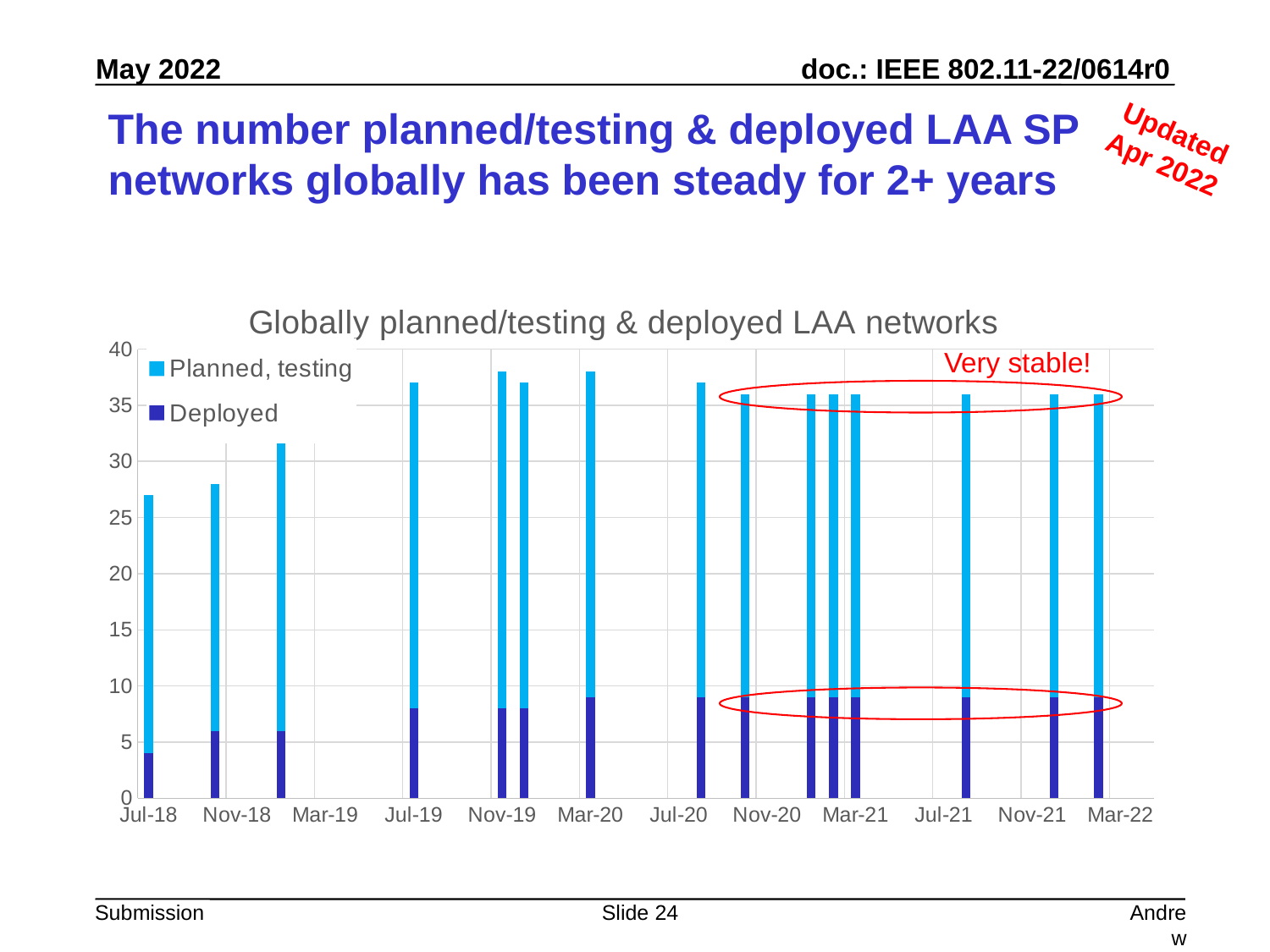
Which has a larger total bar, Jul-18 or Jul-19? Jul-19 Which series is shown in dark blue at the bottom of each bar? Deployed Is the total bar height for Jul-19 greater or less than 35? greater Is the Deployed value for Jul-19 greater or less than 10? less What kind of chart is shown on the slide? Stacked bar chart How many series does the chart legend list? 2 Is the Deployed value for Jul-18 greater or less than 10? less What is the title of the chart? Globally planned/testing & deployed LAA networks Do the total bar heights rise or fall from Jul-18 to Jul-19? rise Which two series are listed in the chart legend? Planned, testing; Deployed